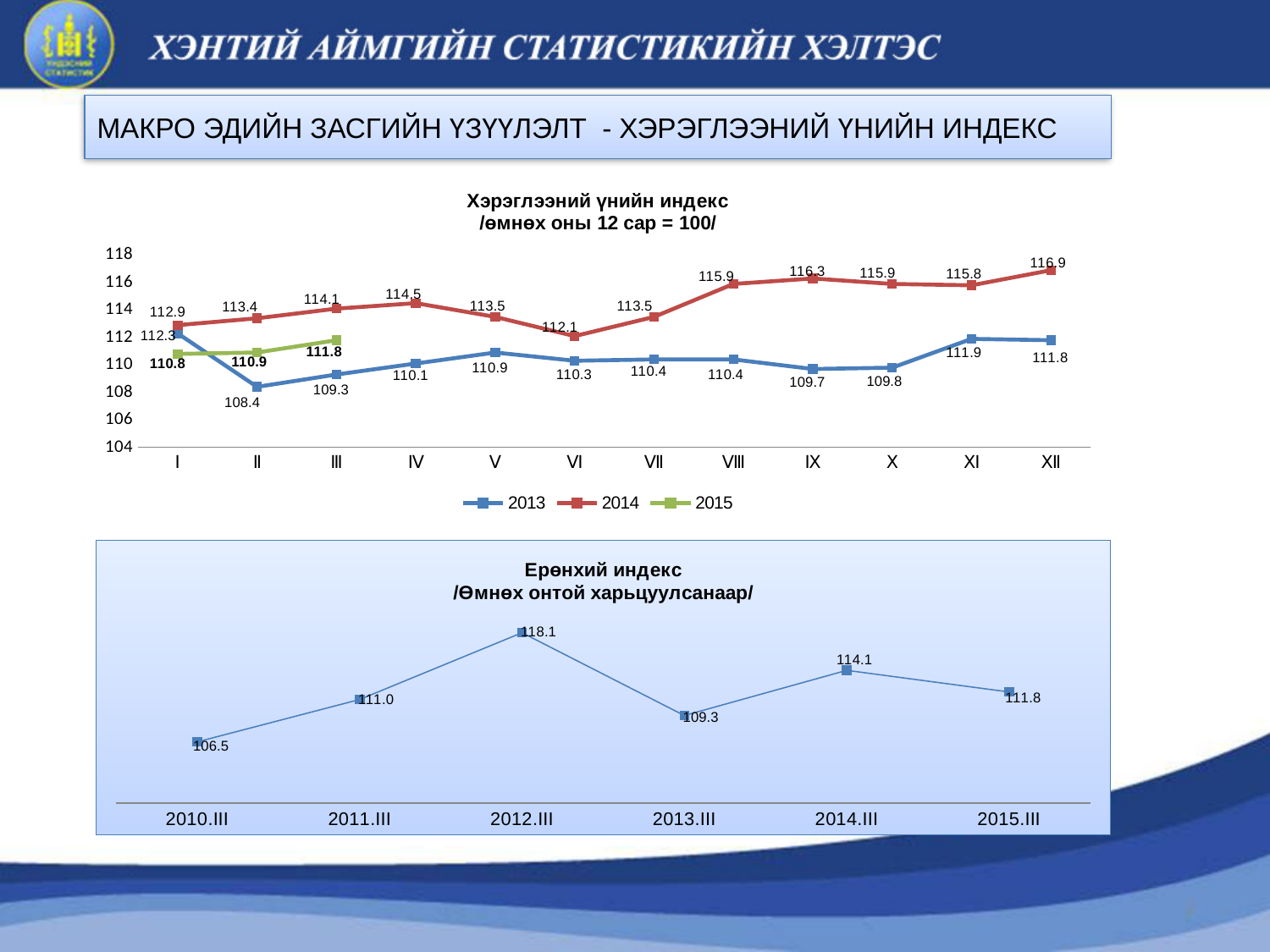
In the bottom chart (Ерөнхий индекс), what is the value for 2010.III? 106.5 What kind of chart is the bottom chart (Ерөнхий индекс)? Line chart In the top chart (Хэрэглээний үнийн индекс), what is the value for the 2014 series in month IX? 116.3 In the top chart (Хэрэглээний үнийн индекс), in which month does the 2013 series have its lowest value? II In the bottom chart (Ерөнхий индекс), which is larger: the value for 2014.III or the value for 2015.III? 2014.III In the top chart (Хэрэглээний үнийн индекс), how many months are shown on the x axis? 12 In the top chart (Хэрэглээний үнийн индекс), what is the value for the 2013 series in month II? 108.4 In the bottom chart (Ерөнхий индекс), which period has the highest value? 2012.III In the top chart (Хэрэглээний үнийн индекс), how many series does the legend list? 3 In the top chart (Хэрэглээний үнийн индекс), in which month does the 2014 series reach its highest value? XII In the top chart (Хэрэглээний үнийн индекс), what is the value for the 2015 series in month III? 111.8 In the top chart (Хэрэглээний үнийн индекс), what is the difference between the 2014 and 2013 values in month XII? 5.1